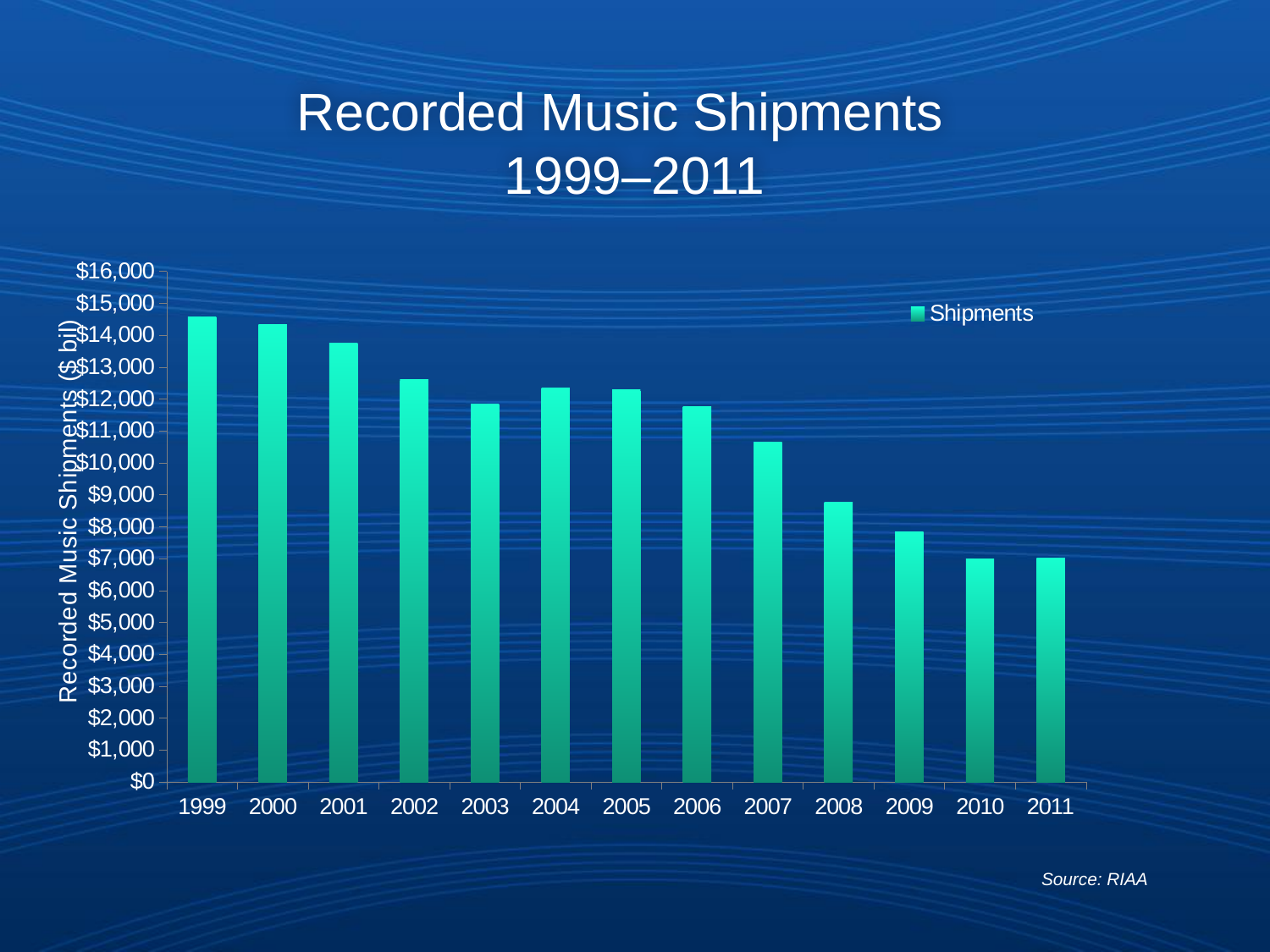
Which is larger, the value for 2001 or the value for 2002? 2001 Which year has the highest shipments value? 1999 How many series does the legend list? 1 Is the value for 2007 greater or less than $10,000? greater What kind of chart is shown on the slide? bar chart Is the value for 1999 greater or less than $14,000? greater Is the value for 2003 greater or less than $12,000? less What is the label of the vertical axis? Recorded Music Shipments ($ bil) Do the shipment values generally rise or fall from 1999 to 2011? fall How many years are plotted on the x axis? 13 What is the title of the chart? Recorded Music Shipments 1999–2011